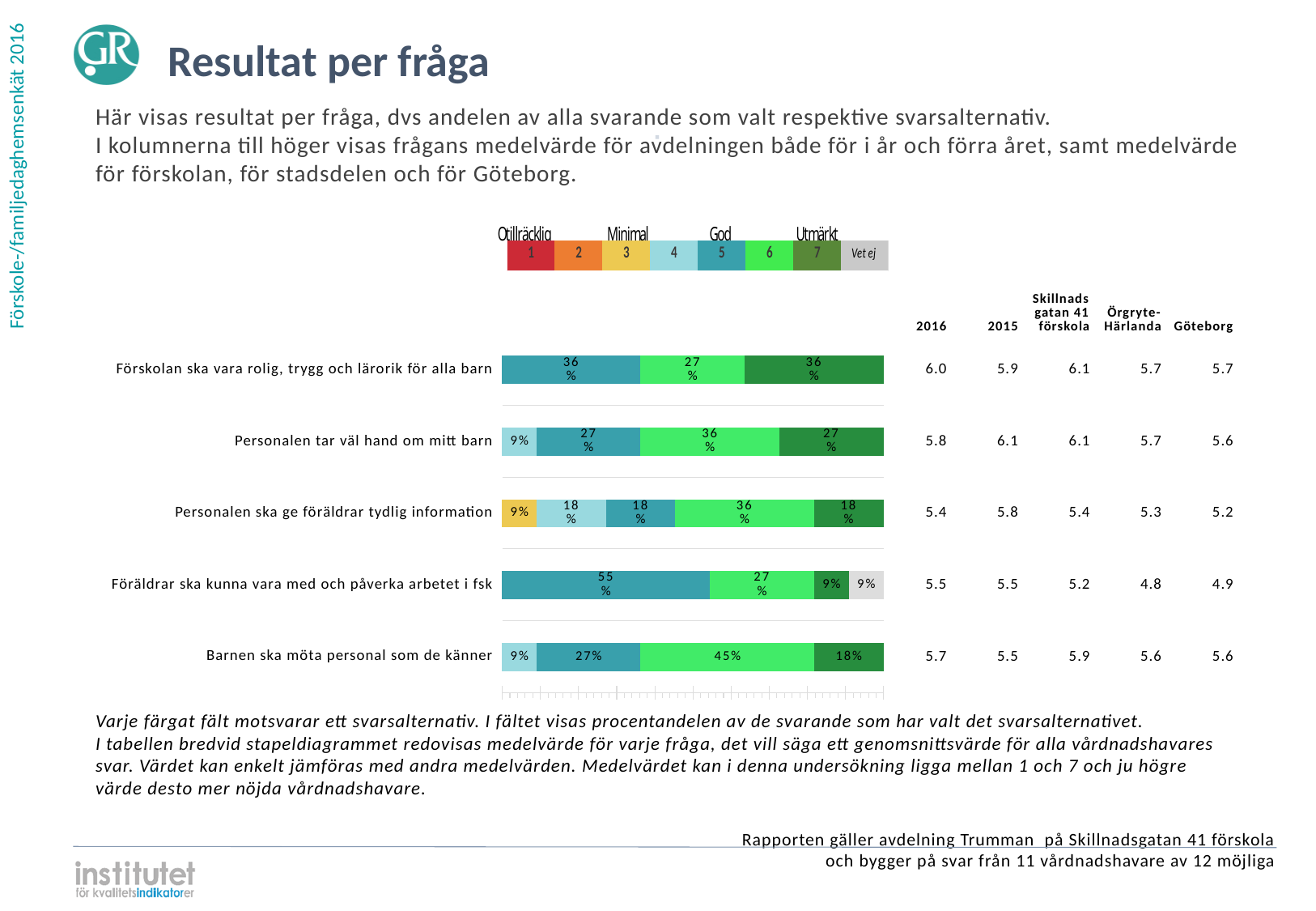
What kind of chart is shown on the slide? Stacked bar chart What percentage of respondents chose alternative 6 for 'Barnen ska möta personal som de känner'? 45% For 'Personalen tar väl hand om mitt barn', which is larger: the share for alternative 6 or alternative 7? Alternative 6 How many questions (bars) are shown in the chart? 5 What percentage chose alternative 7 for 'Förskolan ska vara rolig, trygg och lärorik för alla barn'? 36% Which answer alternative has the largest share for 'Personalen ska ge föräldrar tydlig information'? 6 How many answer alternatives does the legend above the chart list? 8 What is the total of the labelled segments for 'Förskolan ska vara rolig, trygg och lärorik för alla barn'? 99% What is the difference between the share for alternative 6 and alternative 7 for 'Barnen ska möta personal som de känner'? 27% Which answer alternative is shown in the light grey colour in the legend? Vet ej What percentage chose alternative 5 for 'Föräldrar ska kunna vara med och påverka arbetet i fsk'? 55% What percentage answered 'Vet ej' for 'Föräldrar ska kunna vara med och påverka arbetet i fsk'? 9%